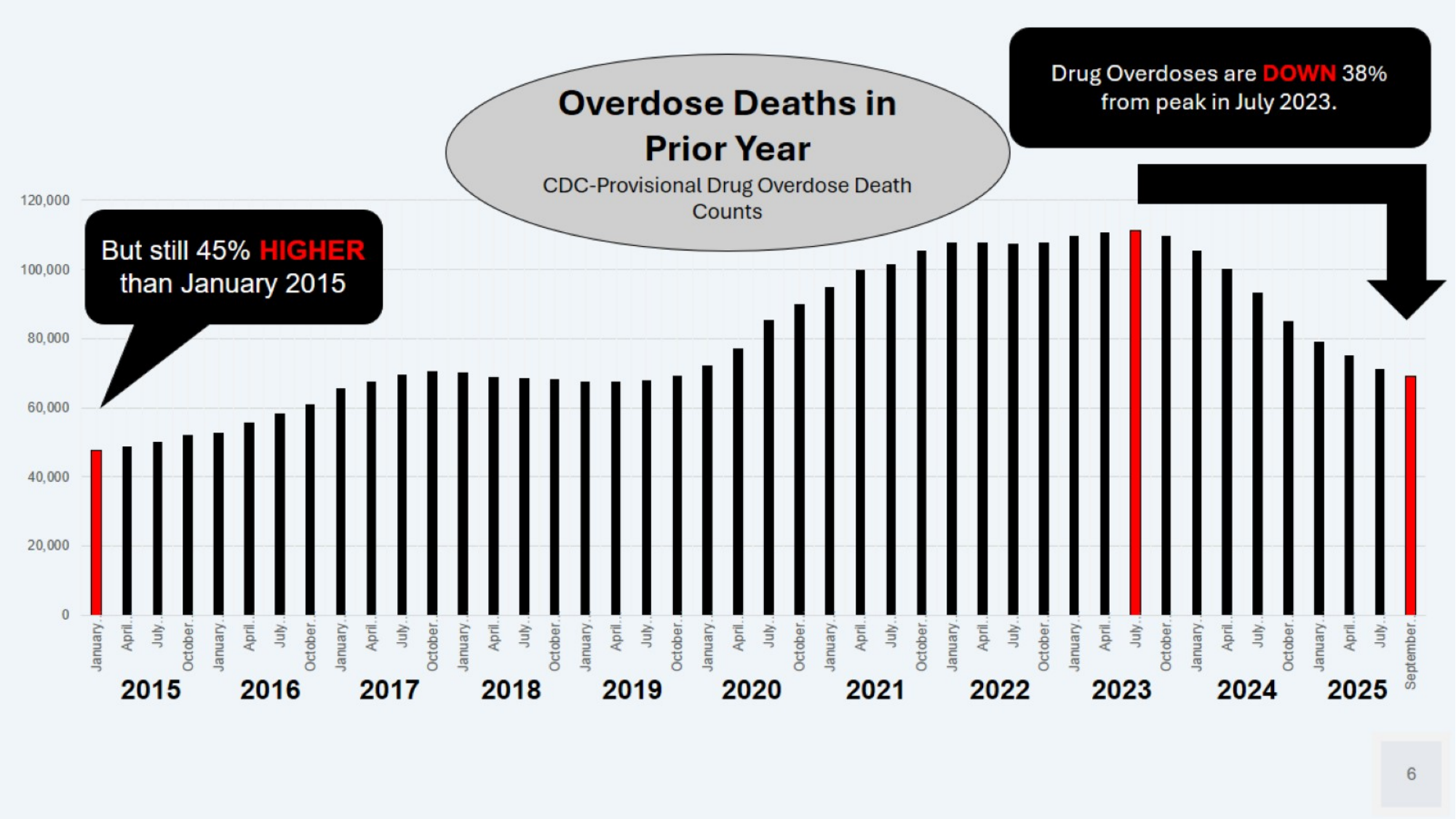
Do the values rise or fall from July 2023 to September 2025? fall Which bar shows the lowest value of overdose deaths in the prior year? January 2015 Which is larger, the value for July 2023 or the value for September 2025? July 2023 What kind of chart is shown on the slide? bar chart How many bars are highlighted in red on the chart? 3 Which is larger, the value for January 2015 or the value for January 2021? January 2021 What is the title of the chart? Overdose Deaths in Prior Year Is the value for January 2015 greater or less than 60,000? less Which bar shows the highest value of overdose deaths in the prior year? July 2023 Is the value for July 2023 greater or less than 100,000? greater Is the value for September 2025 greater or less than 60,000? greater